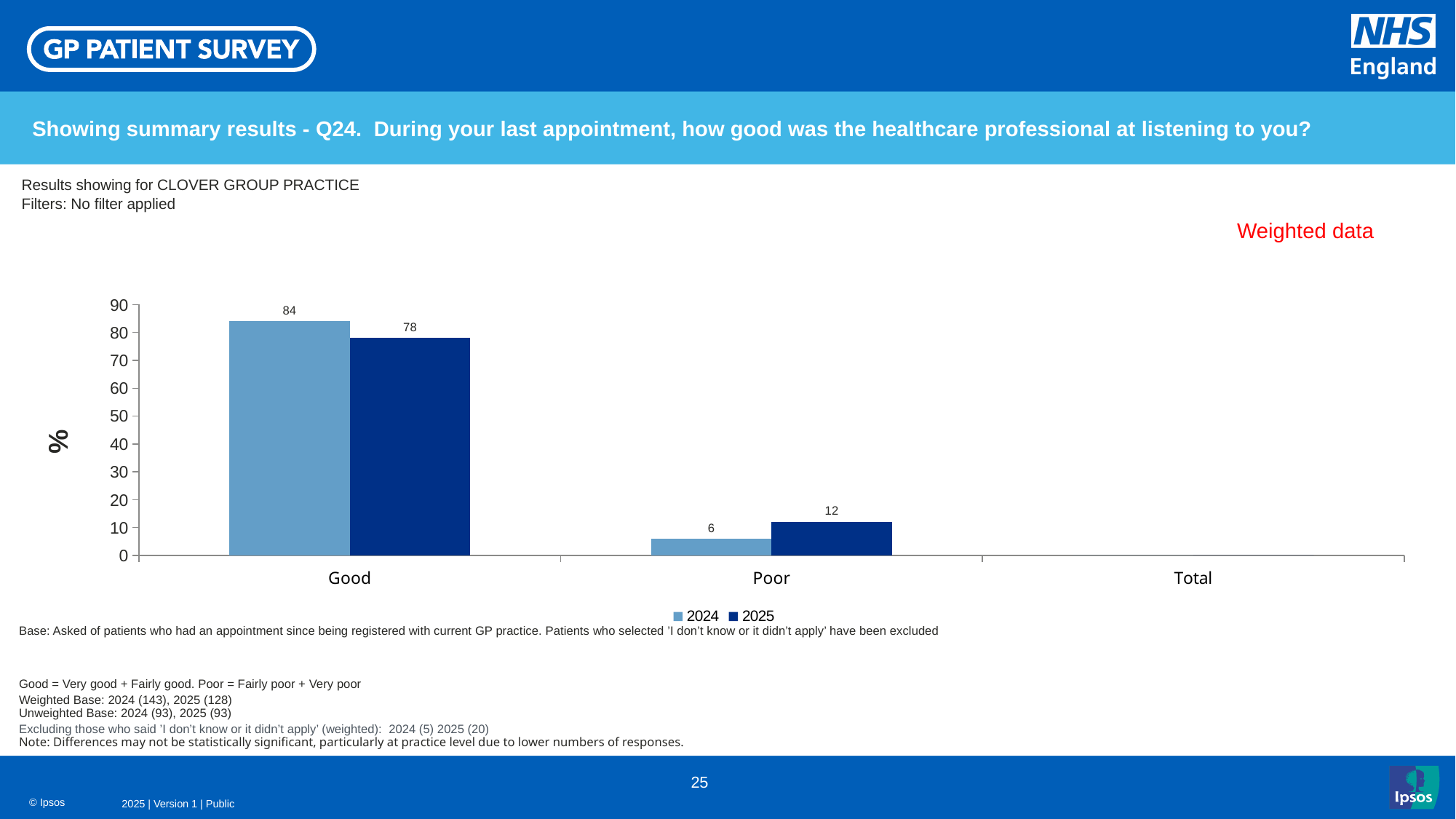
What is the value for Poor in 2025? 12 What kind of chart is shown on the slide? Bar chart Which category has the lowest value in the 2025 series? Poor How many series does the legend list? 2 What is the value for Good in 2024? 84 Which is larger for Poor: the 2024 value or the 2025 value? 2025 What is the value for Good in 2025? 78 What is the difference between the 2024 and 2025 values for Good? 6 Which category has the highest value in the 2024 series? Good What label is shown on the vertical axis of the chart? % What is the value for Poor in 2024? 6 What is the difference between the 2025 and 2024 values for Poor? 6